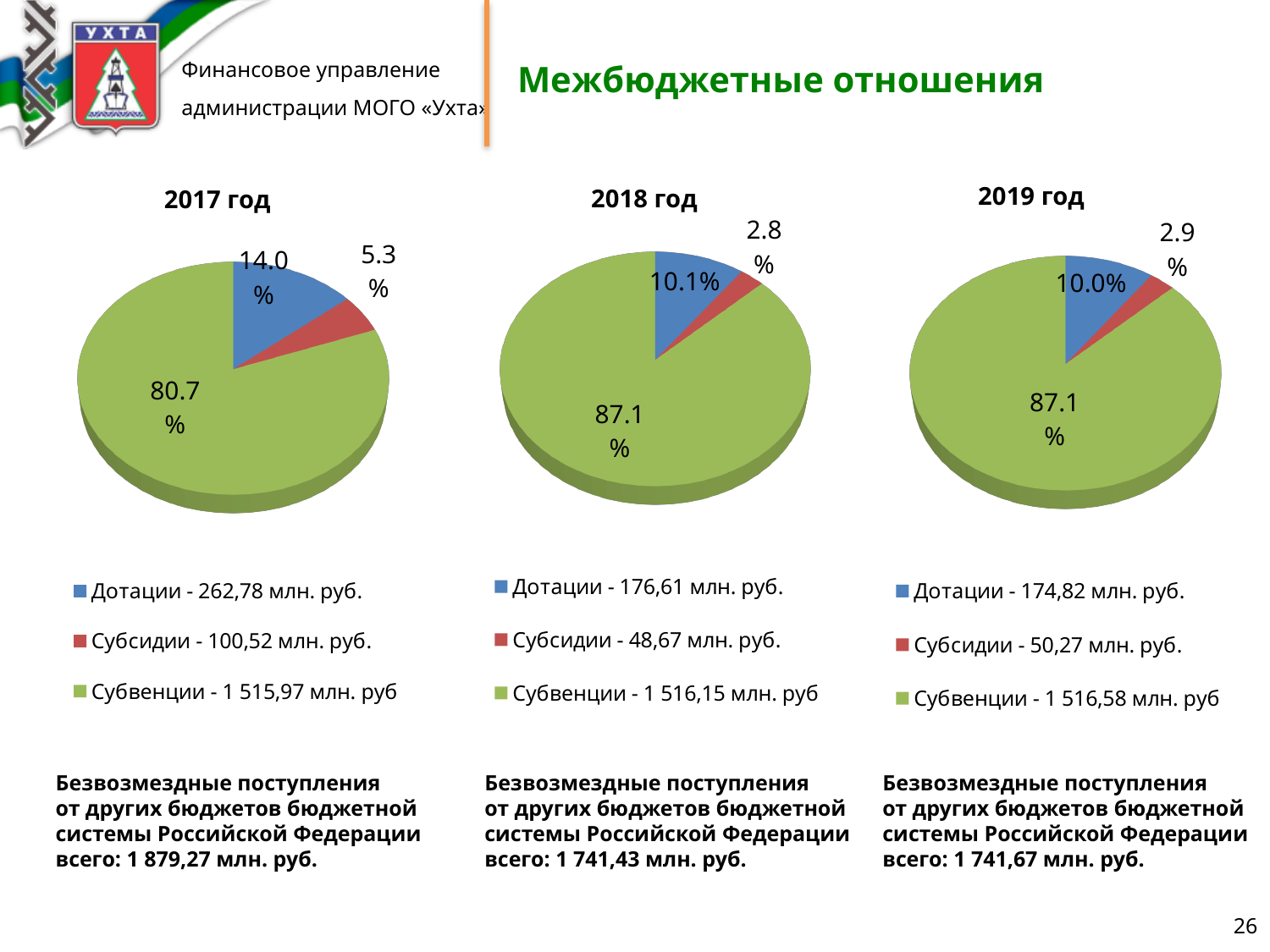
In the 2019 год chart, which slice is larger, Дотации or Субсидии? Дотации In the 2019 год chart, what share of the pie is Дотации? 10.0% In the 2018 год chart, what share of the pie is Субсидии? 2.8% In the 2018 год chart, which category has the smallest slice? Субсидии What kind of chart is used for the 2017 год data? Pie chart In the 2019 год chart, which category has the largest slice? Субвенции In the 2017 год chart, what share of the pie is Дотации? 14.0% In the 2017 год chart, what is the difference in percentage points between the Дотации and Субсидии slices? 8.7 According to the legend of the 2018 год chart, what is the amount for Дотации? 176,61 млн. руб. According to the legend of the 2019 год chart, what is the amount for Субвенции? 1 516,58 млн. руб How many slices does the 2018 год pie chart have? 3